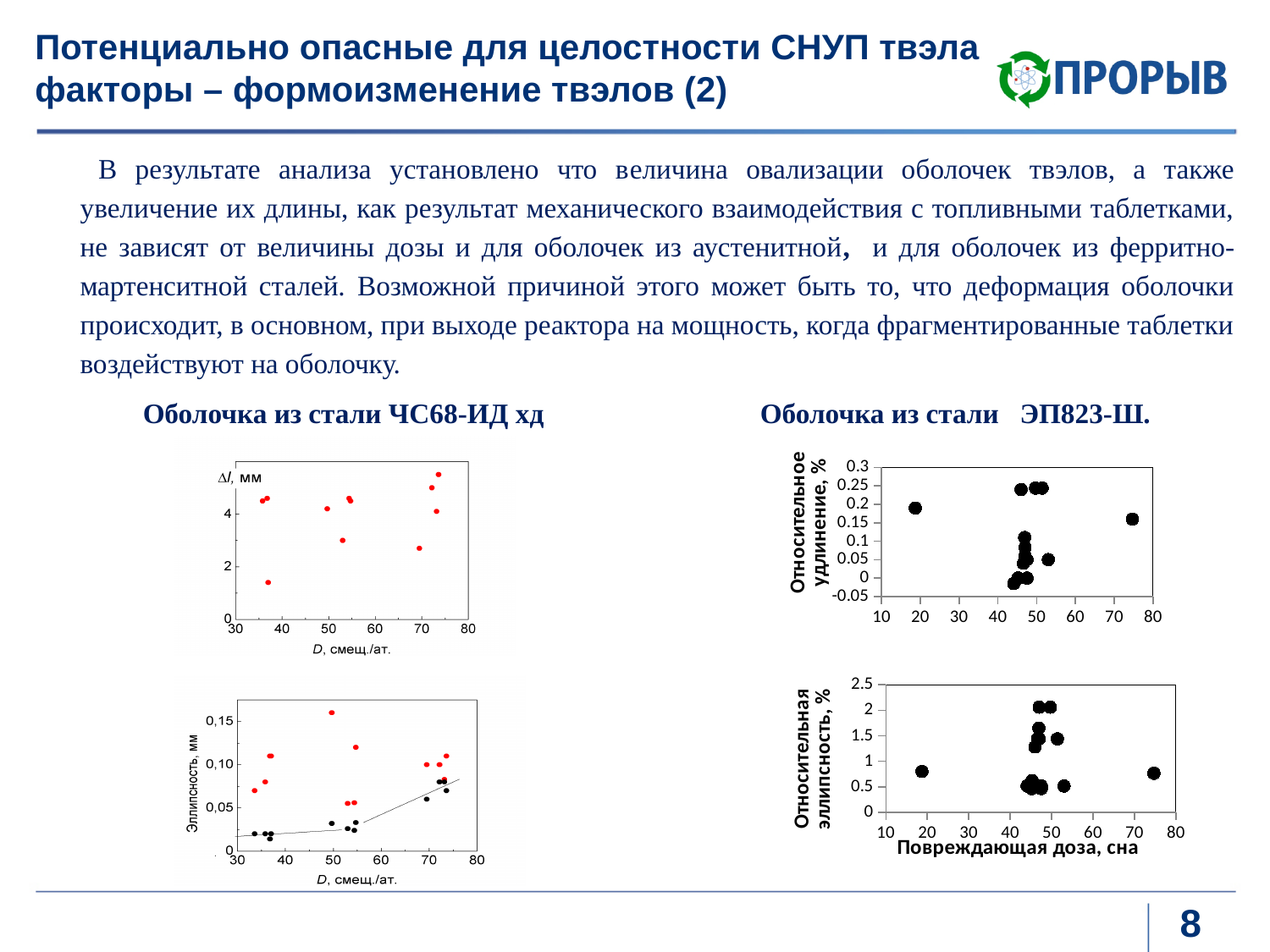
In the bottom-left chart (Эллипсность, мм), is the highest red point, at about 50 смещ./ат., greater or less than 0.10? greater In the bottom-right chart (Относительная эллипсность, %), are the highest points near a dose of 50 сна greater or less than 1.5? greater What kind of chart is the top-left chart under "Оболочка из стали ЧС68-ИД хд"? scatter chart In the top-right chart (Относительное удлинение, %), is the value of the point at a dose of about 75 сна greater or less than 0.1? greater What is the y-axis label of the bottom-left chart? Эллипсность, мм What kind of chart is the bottom-right chart under "Оболочка из стали ЭП823-Ш."? scatter chart What is the x-axis label of the bottom-right chart? Повреждающая доза, сна